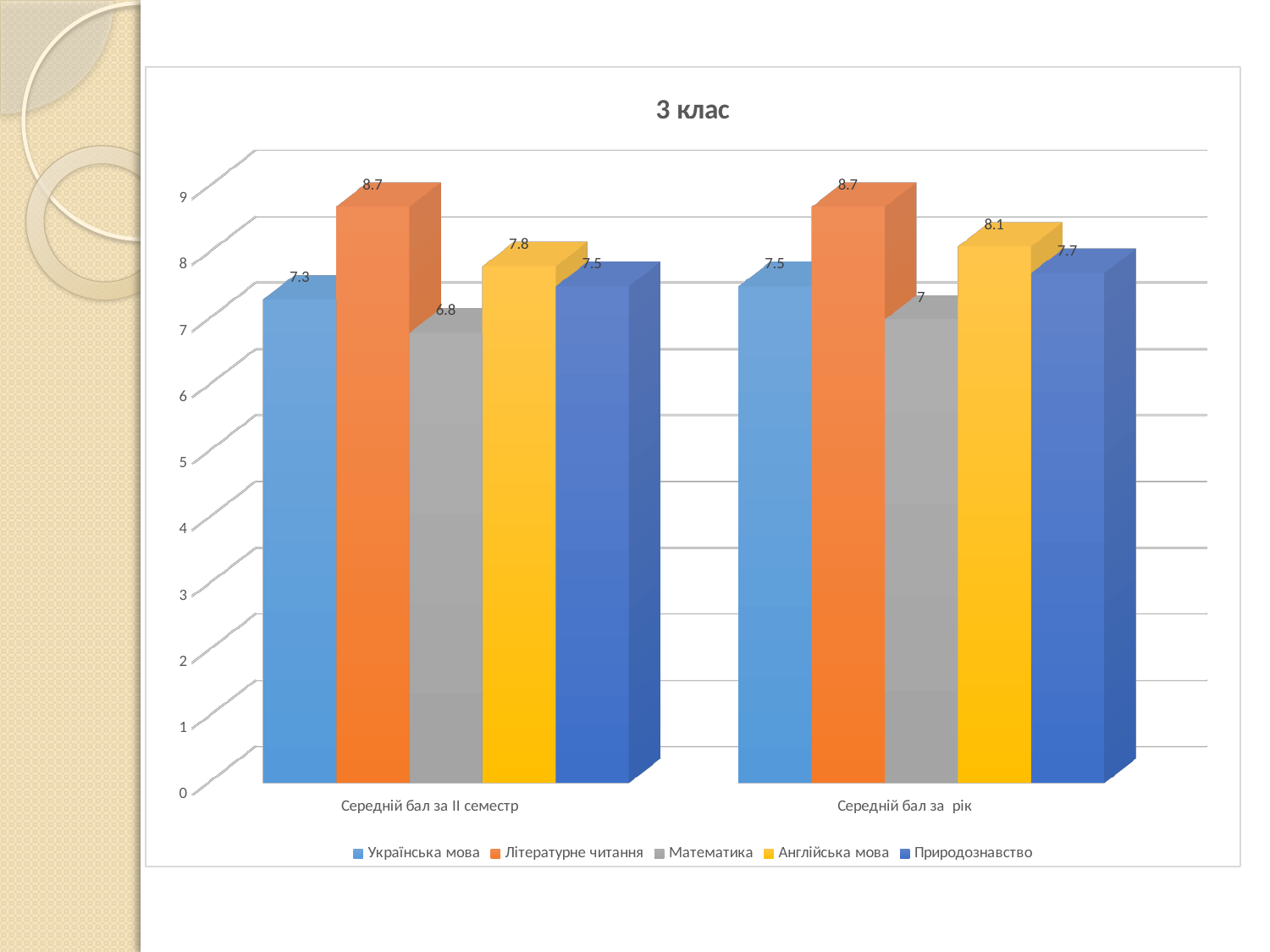
What is the value for Англійська мова in the Середній бал за рік category? 8.1 Does the value for Математика rise or fall from Середній бал за ІІ семестр to Середній бал за рік? Rise What is the value for Природознавство in the Середній бал за ІІ семестр category? 7.5 Which subject has the lowest value in the Середній бал за ІІ семестр category? Математика Which subject has the highest value in the Середній бал за рік category? Літературне читання How many series does the legend list? 5 What is the value for Математика in the Середній бал за ІІ семестр category? 6.8 Which is larger: Українська мова in Середній бал за ІІ семестр or Українська мова in Середній бал за рік? Середній бал за рік What kind of chart is shown on the slide? Bar chart What is the difference between Літературне читання and Математика in the Середній бал за ІІ семестр category? 1.9 What is the title of the chart? 3 клас How many categories are shown on the x axis? 2